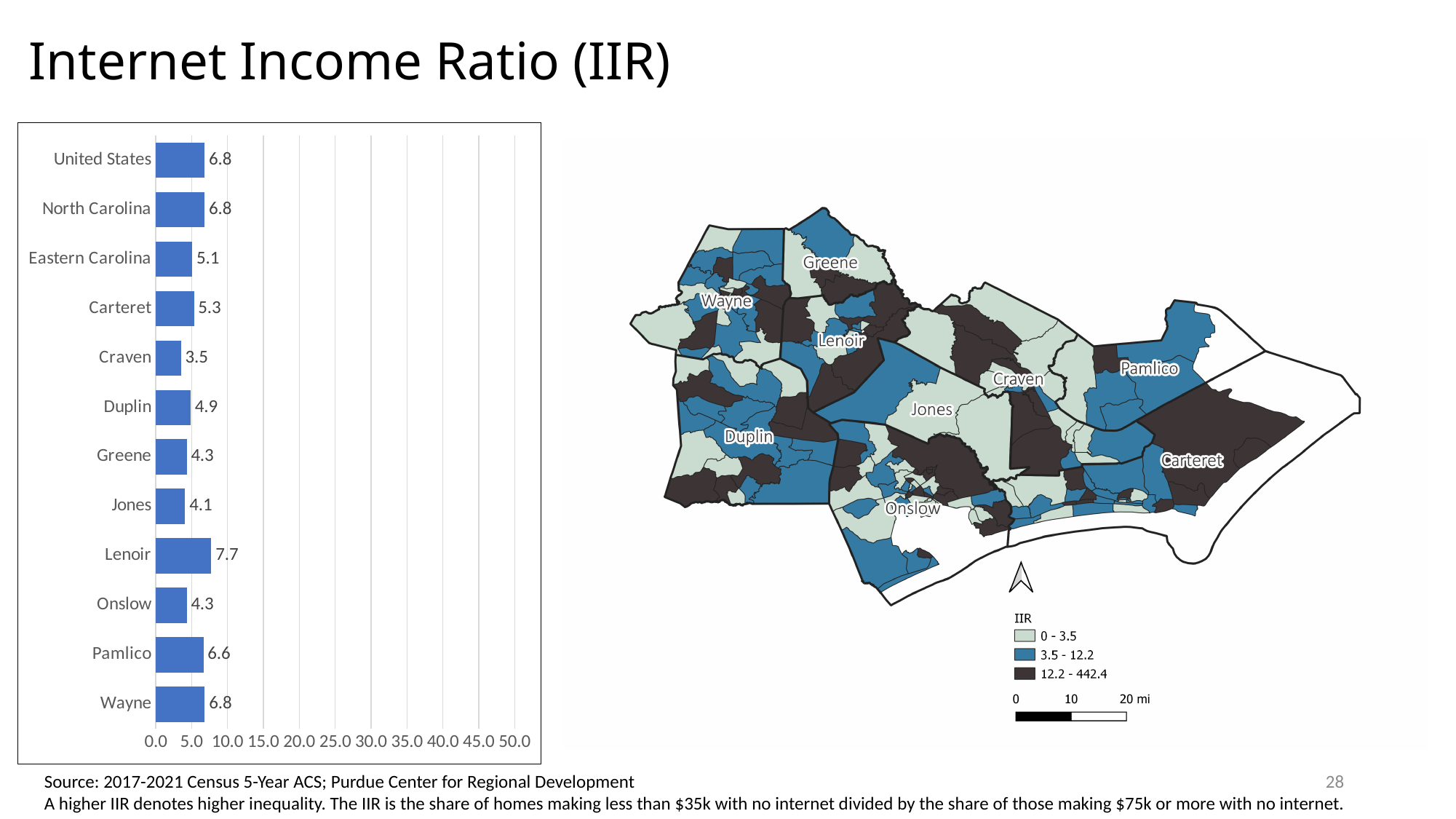
What is the difference between the values for Lenoir and Craven in the bar chart? 4.2 What type of chart is shown on the left side of the slide? bar chart What is the Internet Income Ratio for Eastern Carolina in the bar chart? 5.1 How many categories are shown in the bar chart? 12 Which category has the highest value in the bar chart? Lenoir What is the Internet Income Ratio for Pamlico in the bar chart? 6.6 What is the difference between the values for Carteret and Duplin in the bar chart? 0.4 What is the Internet Income Ratio for Craven in the bar chart? 3.5 What is the Internet Income Ratio for Lenoir in the bar chart? 7.7 Which category has the lowest value in the bar chart? Craven Is the value for Wayne in the bar chart greater or less than 10.0? less Which has a larger value in the bar chart, Pamlico or Jones? Pamlico